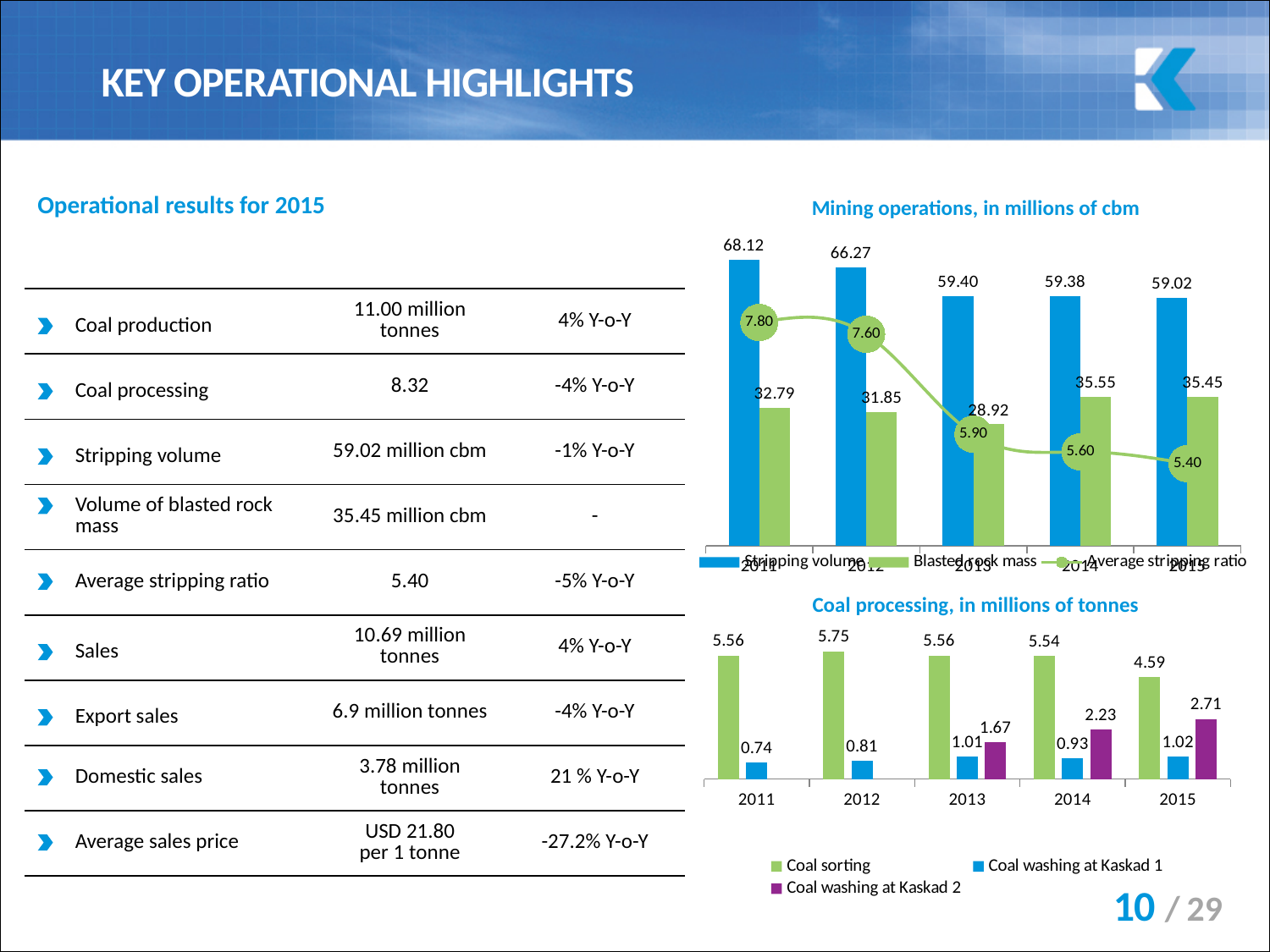
In the 'Mining operations, in millions of cbm' chart, what is the difference between the stripping volume in 2011 and in 2012? 1.85 How many series does the legend of the 'Mining operations, in millions of cbm' chart list? 3 In the 'Mining operations, in millions of cbm' chart, what is the average stripping ratio for 2015? 5.40 In the 'Mining operations, in millions of cbm' chart, does the average stripping ratio rise or fall from 2011 to 2015? fall In the 'Coal processing, in millions of tonnes' chart, what is the coal sorting value for 2012? 5.75 In the 'Coal processing, in millions of tonnes' chart, which year has the lowest coal sorting value? 2015 In the 'Mining operations, in millions of cbm' chart, which year has the highest stripping volume? 2011 In the 'Mining operations, in millions of cbm' chart, which year has the lowest blasted rock mass? 2013 In the 'Coal processing, in millions of tonnes' chart, what is the coal washing at Kaskad 2 value for 2015? 2.71 In the 'Coal processing, in millions of tonnes' chart, is coal washing at Kaskad 1 or coal washing at Kaskad 2 larger in 2014? Coal washing at Kaskad 2 In the 'Mining operations, in millions of cbm' chart, what is the stripping volume for 2011? 68.12 In the 'Mining operations, in millions of cbm' chart, what is the blasted rock mass for 2014? 35.55